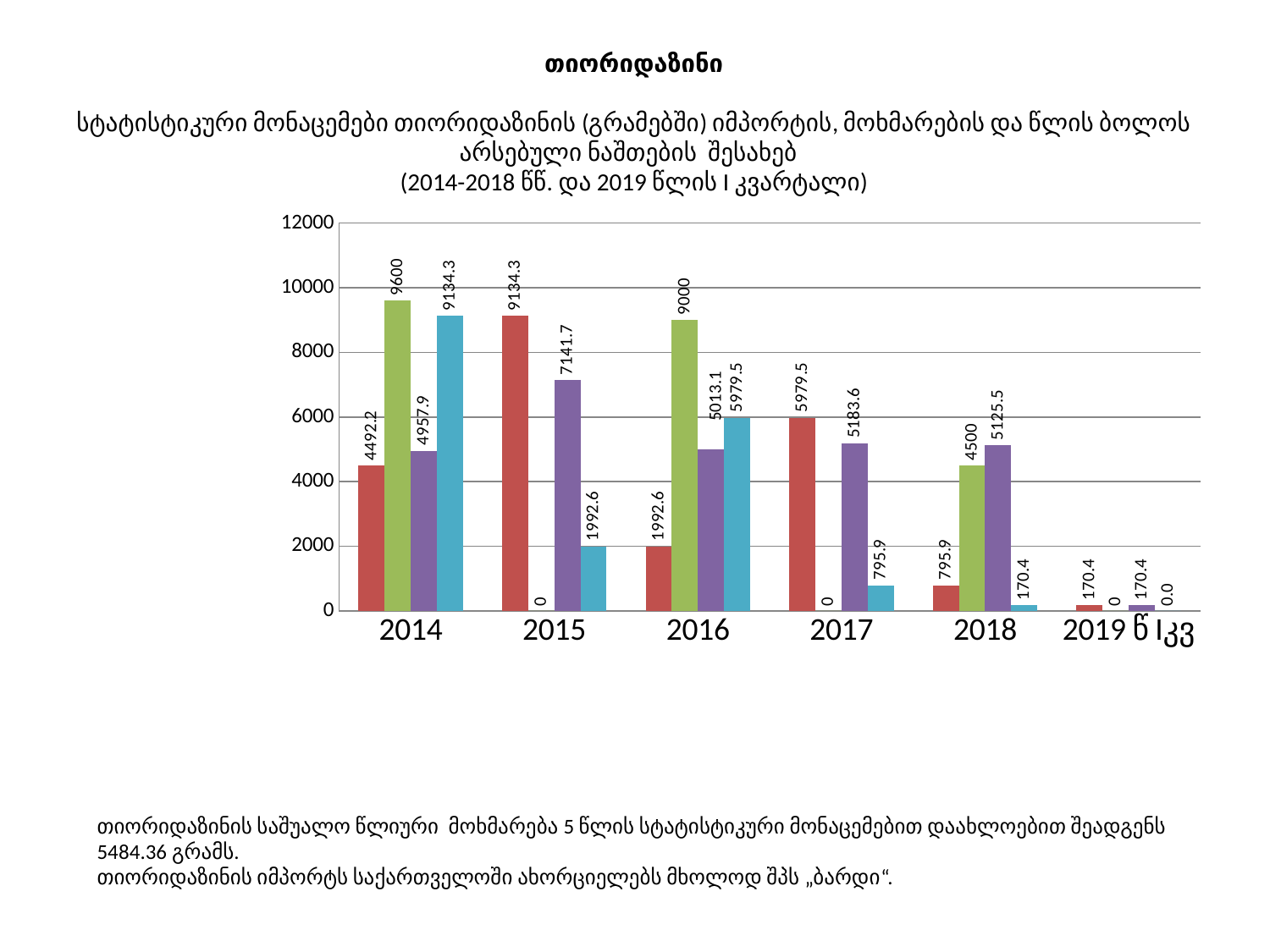
What is the value of the green bar for 2014? 9600 Which is larger for 2016: the purple bar or the teal bar? the teal bar How many categories (time periods) are shown along the x axis of the chart? 6 Which category has the lowest purple bar? 2019 წ I კვ Is the value of the red bar for 2015 greater or less than 8000? greater What is the value of the purple bar for 2015? 7141.7 What is the difference between the green bar for 2014 and the green bar for 2016? 600 Which year has the highest green bar? 2014 What is the value of the teal bar for 2018? 170.4 Does the red bar rise or fall from 2017 to 2019 წ I კვ? fall What kind of chart is shown on the slide? bar chart What is the value of the red bar for 2017? 5979.5